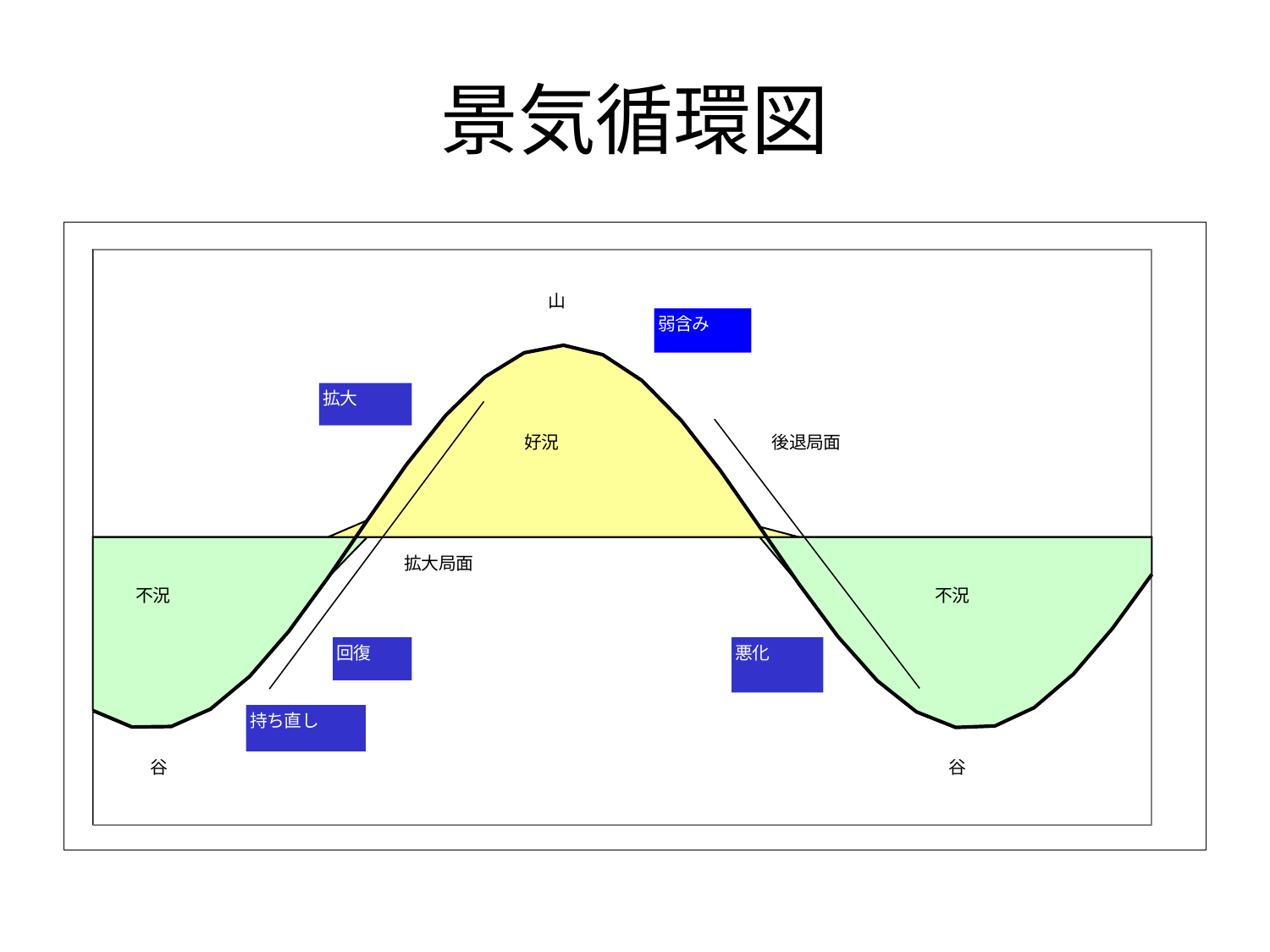
What kind of chart is shown on the slide? area chart What is the title of the chart on the slide? 景気循環図 Does the curve rise or fall from the 山 to the right 谷? fall How many points on the curve are labelled 山? 1 How many points on the curve are labelled 谷? 2 Does the curve rise or fall from the left 谷 to the 山? rise What colour is the area labelled 好況 above the horizontal line? yellow